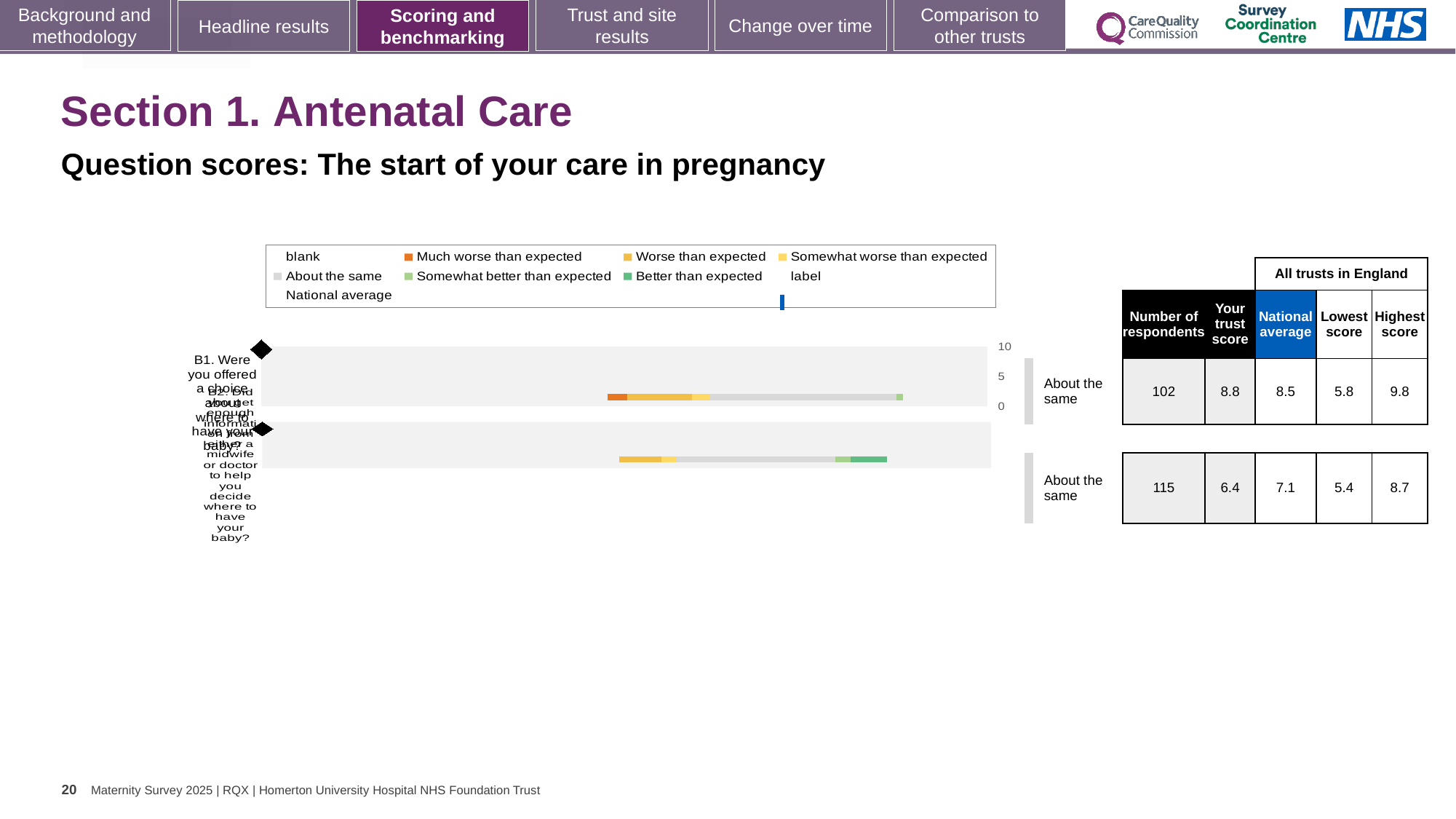
In the table beside the chart, how many respondents are listed for question B1? 102 How many survey questions are plotted on the chart? 2 What is the lowest score among all trusts in England for question B2? 5.4 What is the highest score among all trusts in England for question B1? 9.8 What is the 'Your trust score' value for question B1 (Were you offered a choice about where to have your baby?)? 8.8 For question B2, how much lower is the trust score than the national average? 0.7 What is the national average score for question B2? 7.1 What benchmark category is shown next to the chart for both questions B1 and B2? About the same Which legend entry is shown in dark orange? Much worse than expected For question B1, what is the difference between the trust score and the national average? 0.3 For question B1, which is larger: the trust score or the national average? Your trust score What kind of chart is shown on the slide? Bar chart